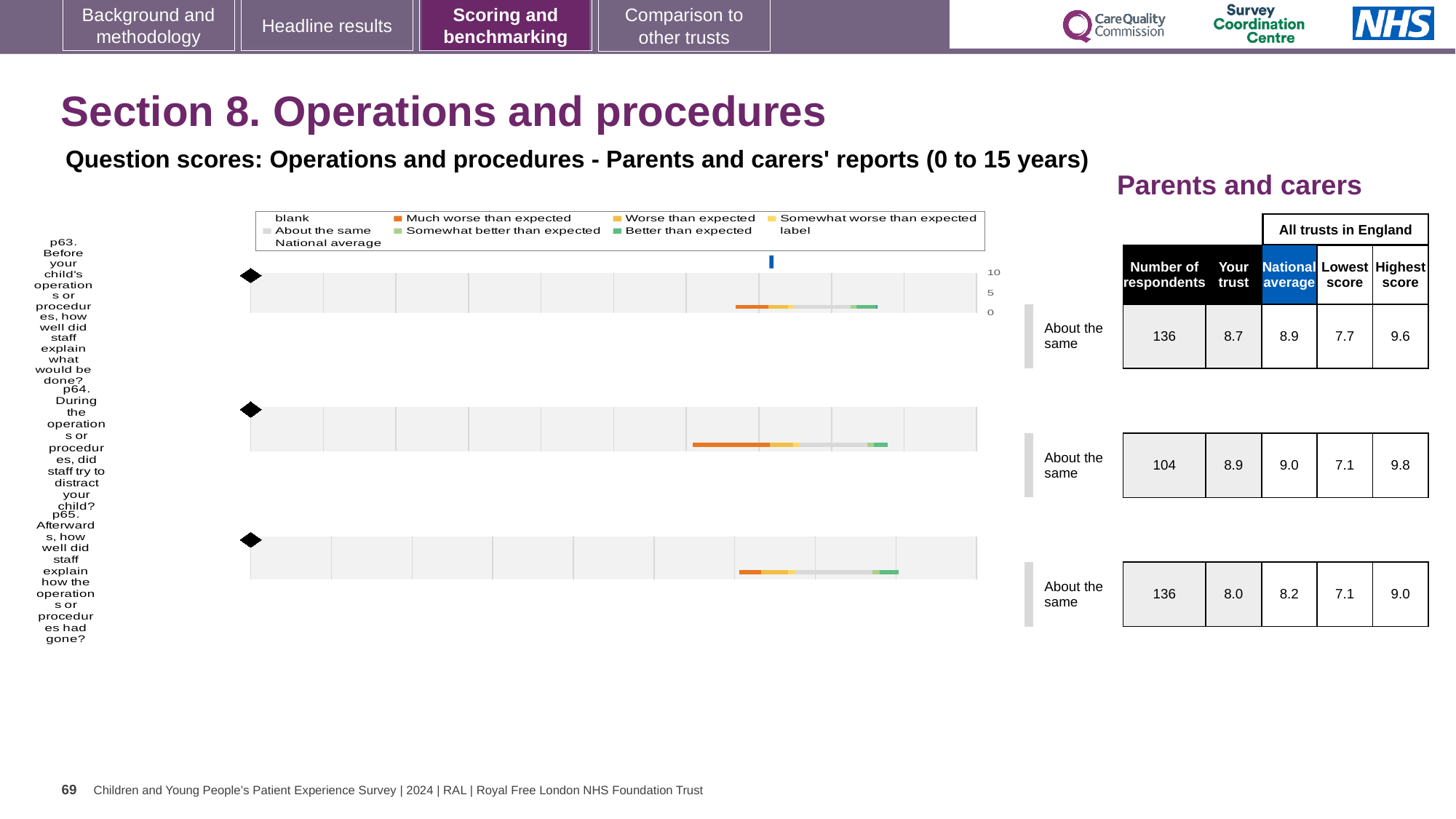
How many respondents answered p64? 104 What benchmark category is shown for p63? About the same What is the 'Your trust' score for p63 (Before your child's operations or procedures, how well did staff explain what would be done?)? 8.7 For p65, which is larger: the 'Your trust' score or the national average? National average Which question has the highest 'Your trust' score? p64 What is the lowest score across all trusts in England for p63? 7.7 How many questions (p63, p64, p65) are plotted in the chart? 3 What is the difference between the highest score and the lowest score for p64? 2.7 Which question has the lowest 'Your trust' score? p65 What kind of chart is used to show the question scores on this slide? bar chart What is the national average score for p64 (During the operations or procedures, did staff try to distract your child?)? 9.0 What is the highest score across all trusts in England for p65 (Afterwards, how well did staff explain how the operations or procedures had gone?)? 9.0